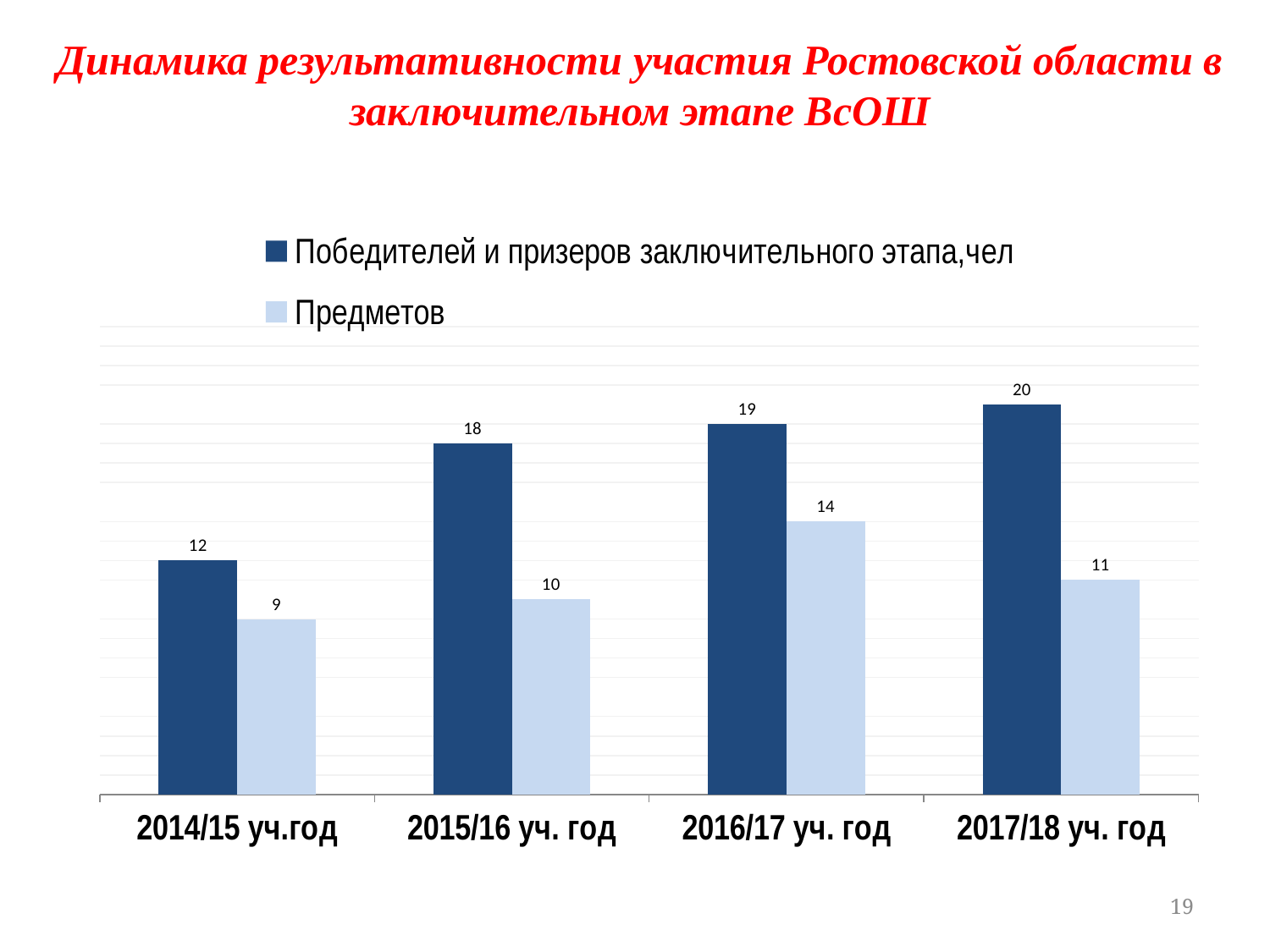
What kind of chart is shown on the slide? Bar chart In which year is the value for "Предметов" lowest? 2014/15 уч.год What is the value for "Предметов" in 2015/16 уч. год? 10 What is the value for "Победителей и призеров заключительного этапа,чел" in 2014/15 уч.год? 12 Does the value for "Победителей и призеров заключительного этапа,чел" rise or fall from 2014/15 уч.год to 2017/18 уч. год? Rise What is the difference between "Победителей и призеров заключительного этапа,чел" and "Предметов" in 2015/16 уч. год? 8 In which year is the value for "Победителей и призеров заключительного этапа,чел" highest? 2017/18 уч. год How many years are shown on the x axis? 4 What is the value for "Победителей и призеров заключительного этапа,чел" in 2017/18 уч. год? 20 How many series does the legend list? 2 Which is larger: "Предметов" in 2016/17 уч. год or "Предметов" in 2017/18 уч. год? 2016/17 уч. год What is the value for "Предметов" in 2016/17 уч. год? 14